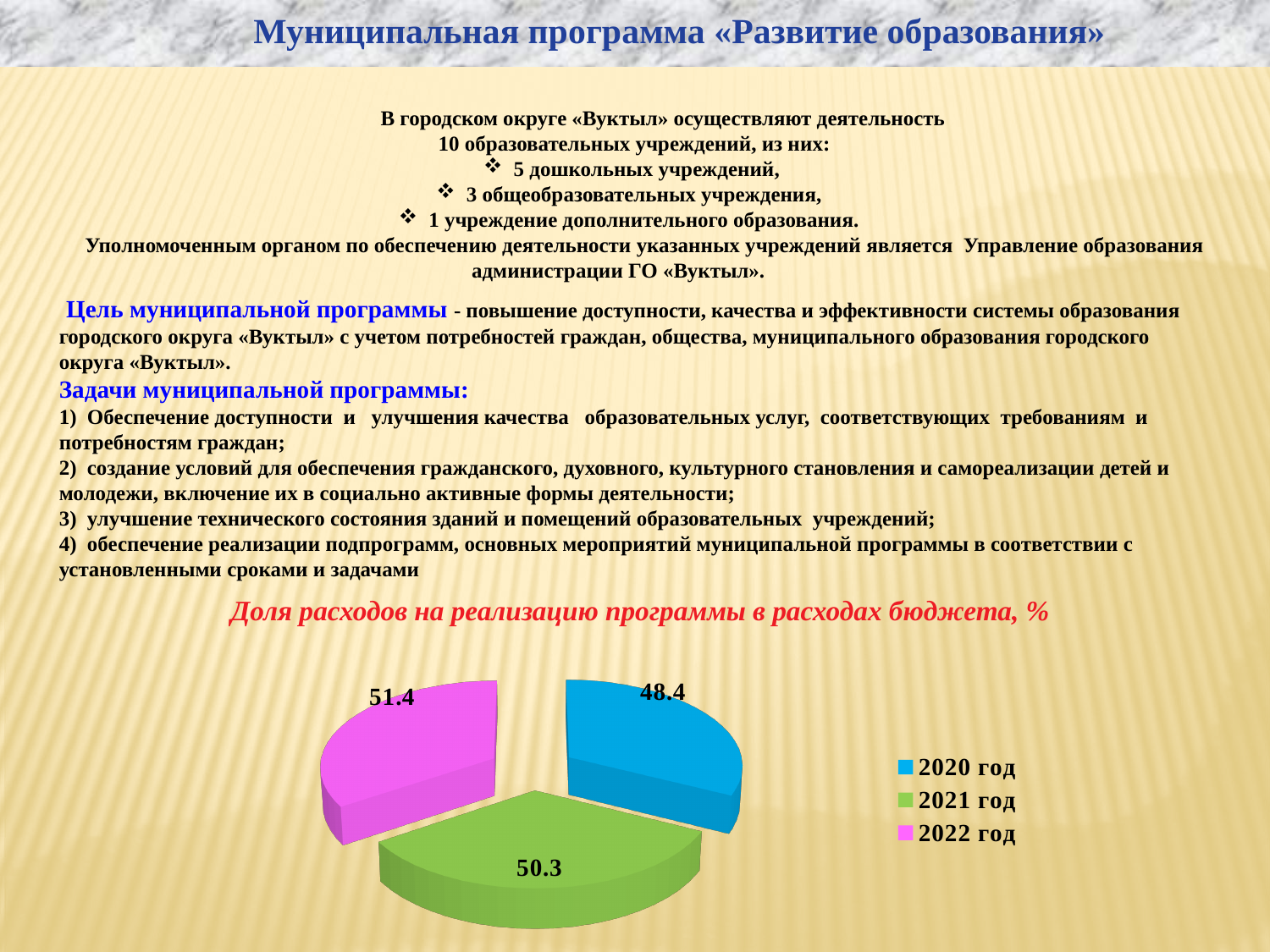
What is the value shown for 2021 год in the pie chart? 50.3 What is the difference between the values for 2022 год and 2020 год? 3.0 What colour is the slice for 2021 год in the pie chart? Green Which year has the lowest value in the pie chart? 2020 год What is the difference between the values for 2021 год and 2020 год? 1.9 How many slices does the pie chart have? 3 What kind of chart is shown on the slide? Pie chart Which is larger, the value for 2021 год or the value for 2022 год? 2022 год Do the values rise or fall from 2020 год to 2022 год? Rise What is the value shown for 2022 год in the pie chart? 51.4 Which year has the highest value in the pie chart? 2022 год What is the value shown for 2020 год in the pie chart? 48.4